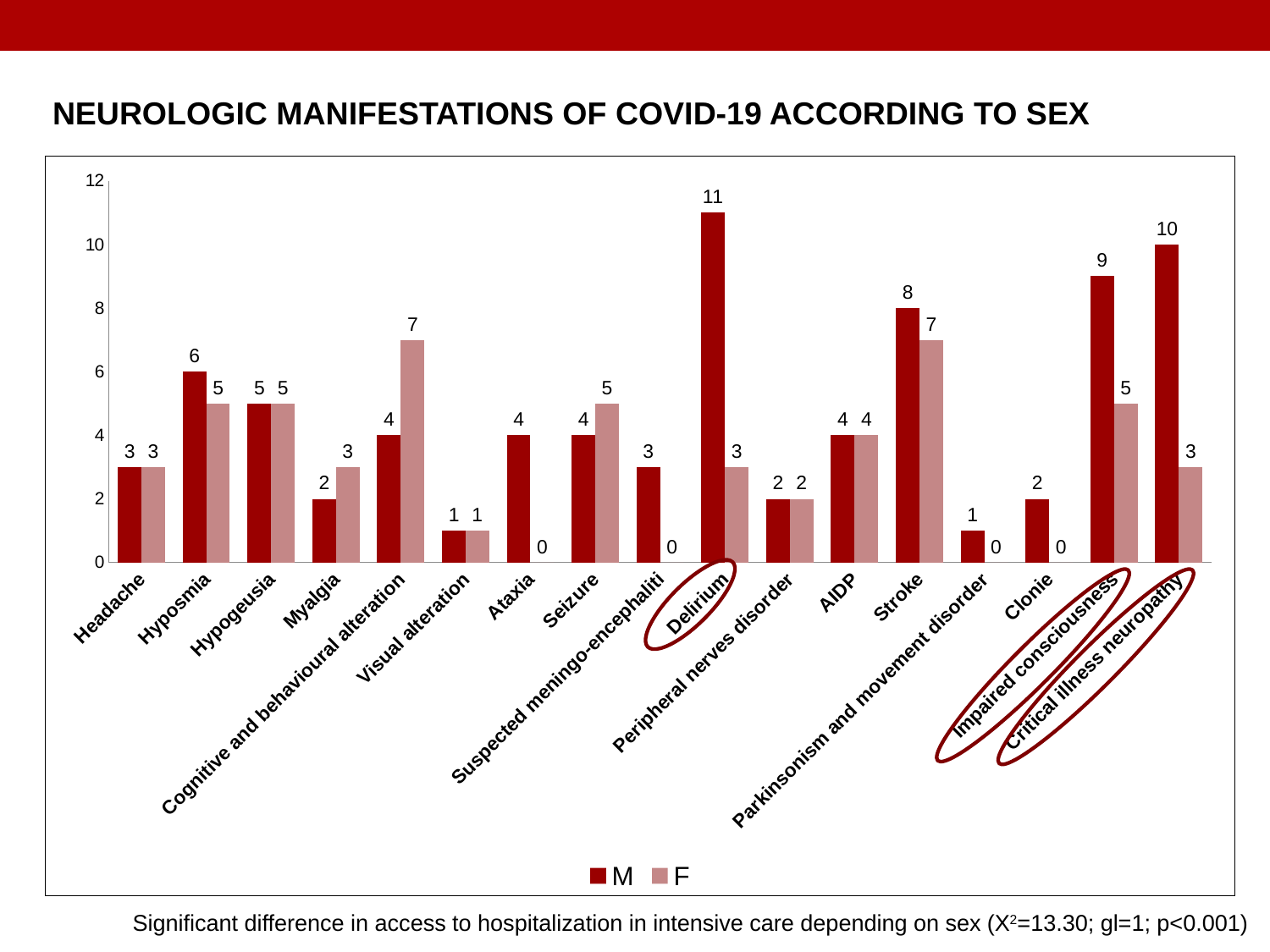
Which is larger for Seizure, the M value or the F value? F Which is larger for Stroke, the M value or the F value? M Which category has the highest F value? Cognitive and behavioural alteration and Stroke (tied at 7) How many categories are shown on the x axis? 17 What is the difference between the M and F values for Delirium? 8 What is the value for F in the Cognitive and behavioural alteration category? 7 What is the value for F in the Critical illness neuropathy category? 3 What kind of chart is shown on the slide? Bar chart What is the difference between the M and F values for Impaired consciousness? 4 Which category has the highest M value? Delirium What is the value for M in the Delirium category? 11 How many series does the legend list? 2